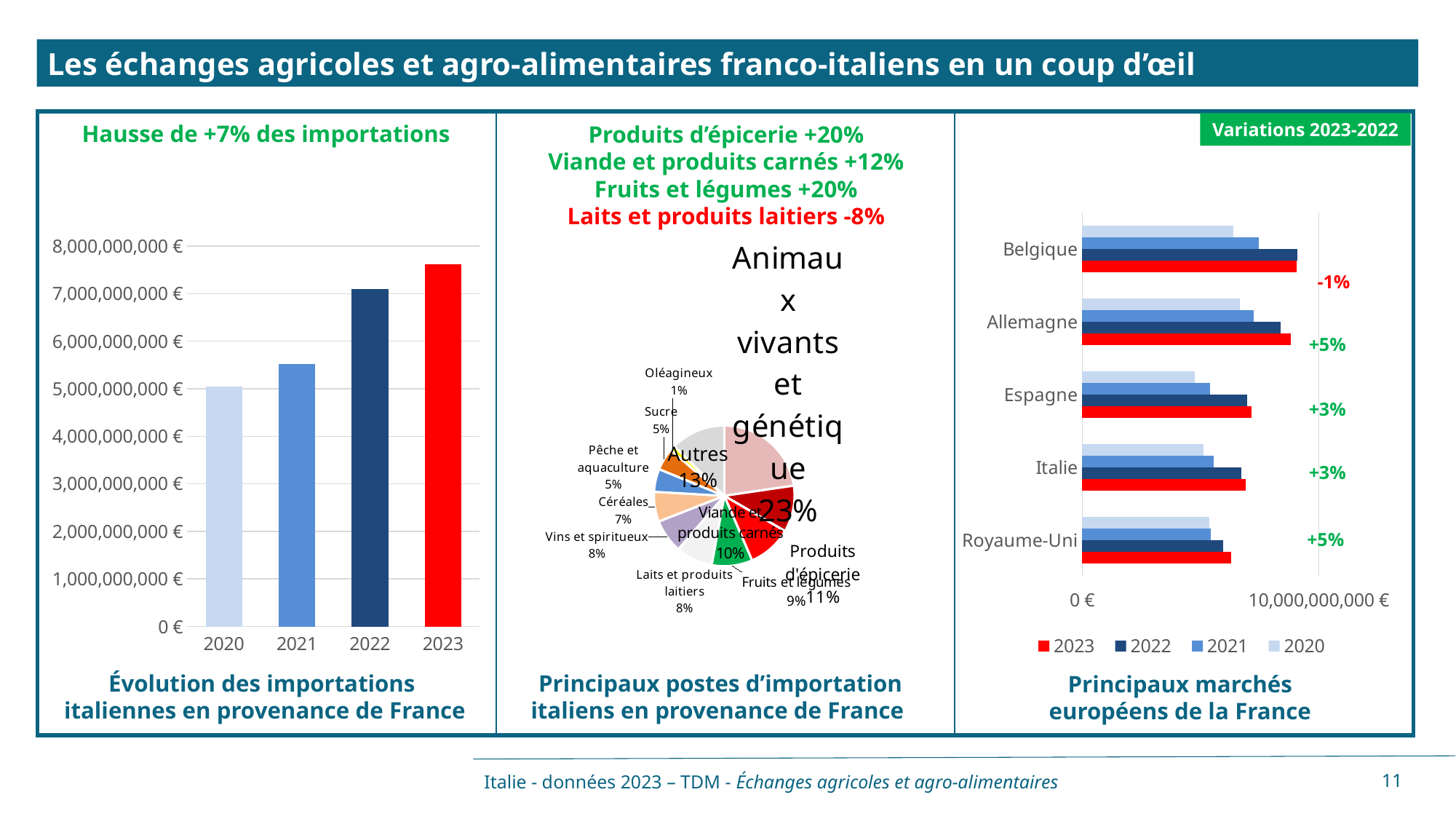
In the left chart 'Évolution des importations italiennes en provenance de France', is the value for 2020 greater or less than 6,000,000,000 €? less In the middle pie chart 'Principaux postes d'importation italiens en provenance de France', which category has the largest slice? Animaux vivants et génétique What kind of chart is the left chart, 'Évolution des importations italiennes en provenance de France'? bar chart In the middle pie chart 'Principaux postes d'importation italiens en provenance de France', how many slices are there? 11 In the left chart 'Évolution des importations italiennes en provenance de France', how many years are shown on the x axis? 4 In the middle pie chart 'Principaux postes d'importation italiens en provenance de France', what share does 'Animaux vivants et génétique' have? 23% In the right chart 'Principaux marchés européens de la France', what variation 2023-2022 is shown next to Belgique? -1% In the left chart 'Évolution des importations italiennes en provenance de France', do the values rise or fall from 2020 to 2023? rise In the right chart 'Principaux marchés européens de la France', how many series does the legend list? 4 In the left chart 'Évolution des importations italiennes en provenance de France', which year has the lowest value? 2020 In the middle pie chart 'Principaux postes d'importation italiens en provenance de France', what is the percentage for Oléagineux? 1% In the left chart 'Évolution des importations italiennes en provenance de France', is the value for 2023 greater or less than 7,000,000,000 €? greater